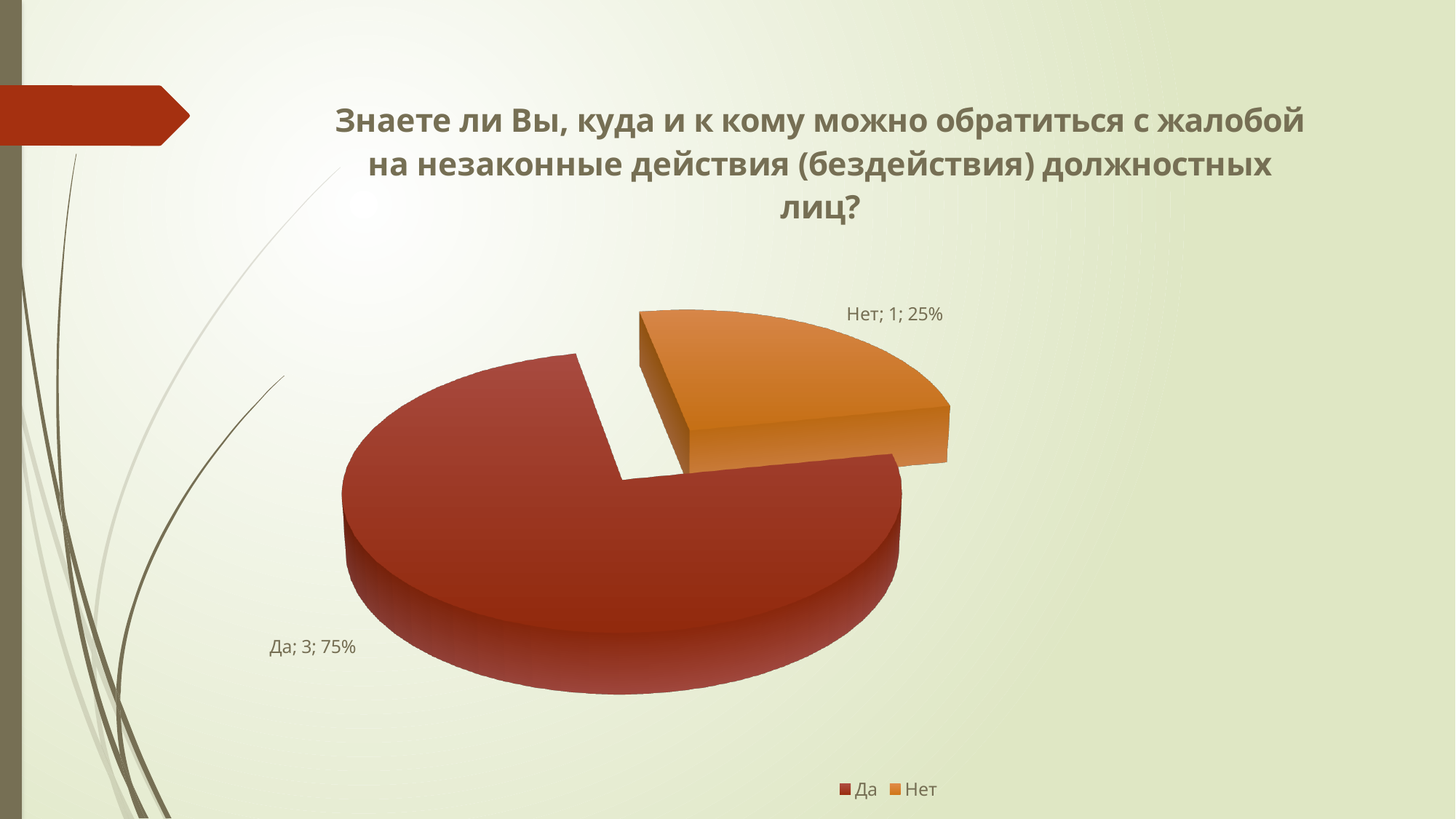
What is the value for "Да"? 3 How many entries does the legend list? 2 What share of the pie does "Нет" represent? 25% What colour is the "Нет" slice? orange Which category has the largest slice? Да What kind of chart is shown on the slide? pie chart Which is larger, the value for "Да" or the value for "Нет"? Да What is the value for "Нет"? 1 What share of the pie does "Да" represent? 75% What is the difference between the values for "Да" and "Нет"? 2 Which category has the smallest slice? Нет How many slices does the pie chart have? 2